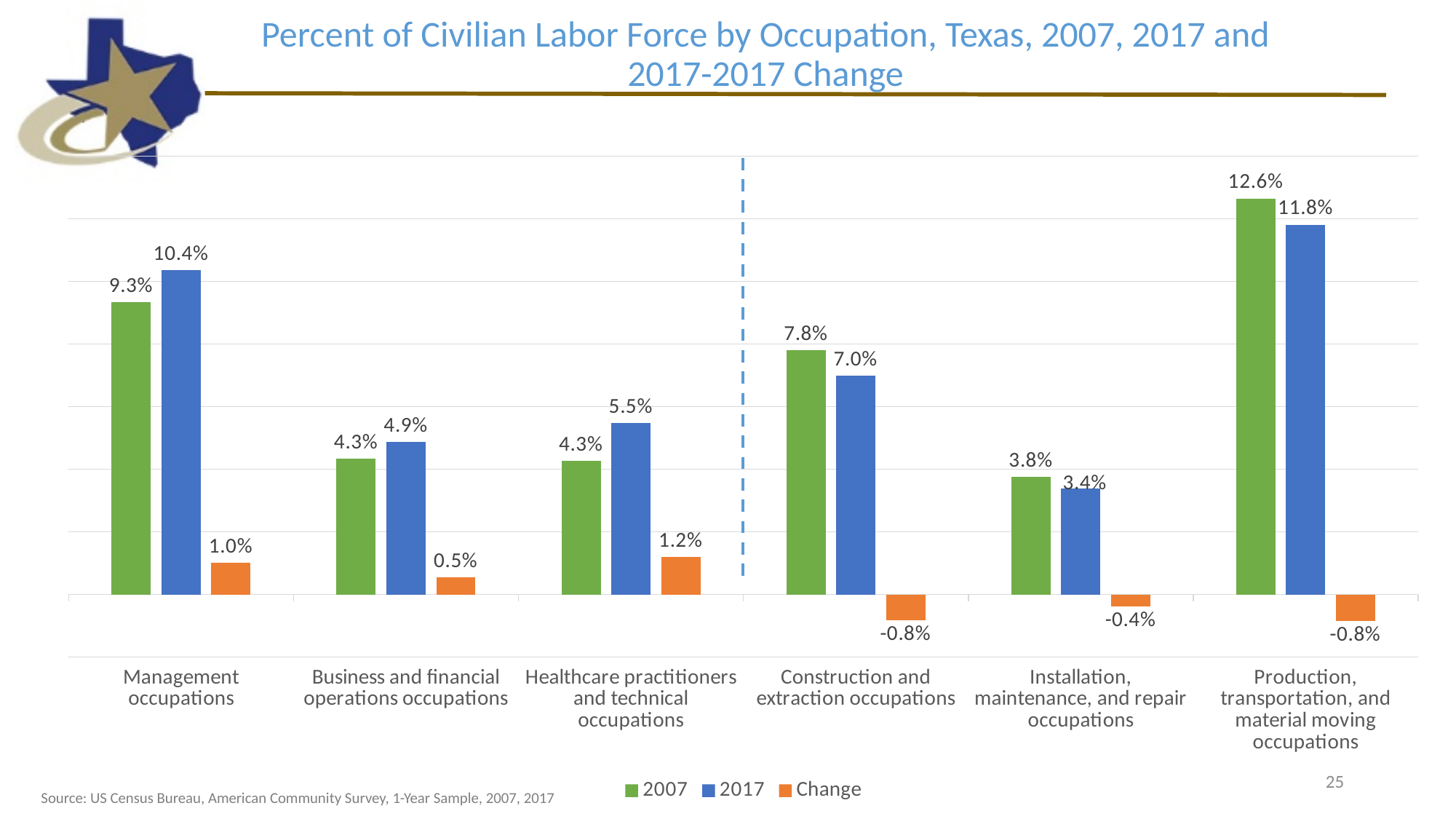
Which is larger for Production, transportation, and material moving occupations: the 2007 value or the 2017 value? 2007 Which occupation has the lowest 2017 value? Installation, maintenance, and repair occupations What is the 2017 value for Management occupations? 10.4% Which occupation has the highest 2007 value? Production, transportation, and material moving occupations What kind of chart is shown on the slide? Bar chart What is the Change value for Healthcare practitioners and technical occupations? 1.2% What is the difference between the 2017 and 2007 values for Business and financial operations occupations? 0.6% What is the 2007 value for Construction and extraction occupations? 7.8% What is the Change value for Installation, maintenance, and repair occupations? -0.4% How many occupation categories are shown on the chart? 6 How many series does the legend list? 3 Which colour represents the Change series in the chart? Orange